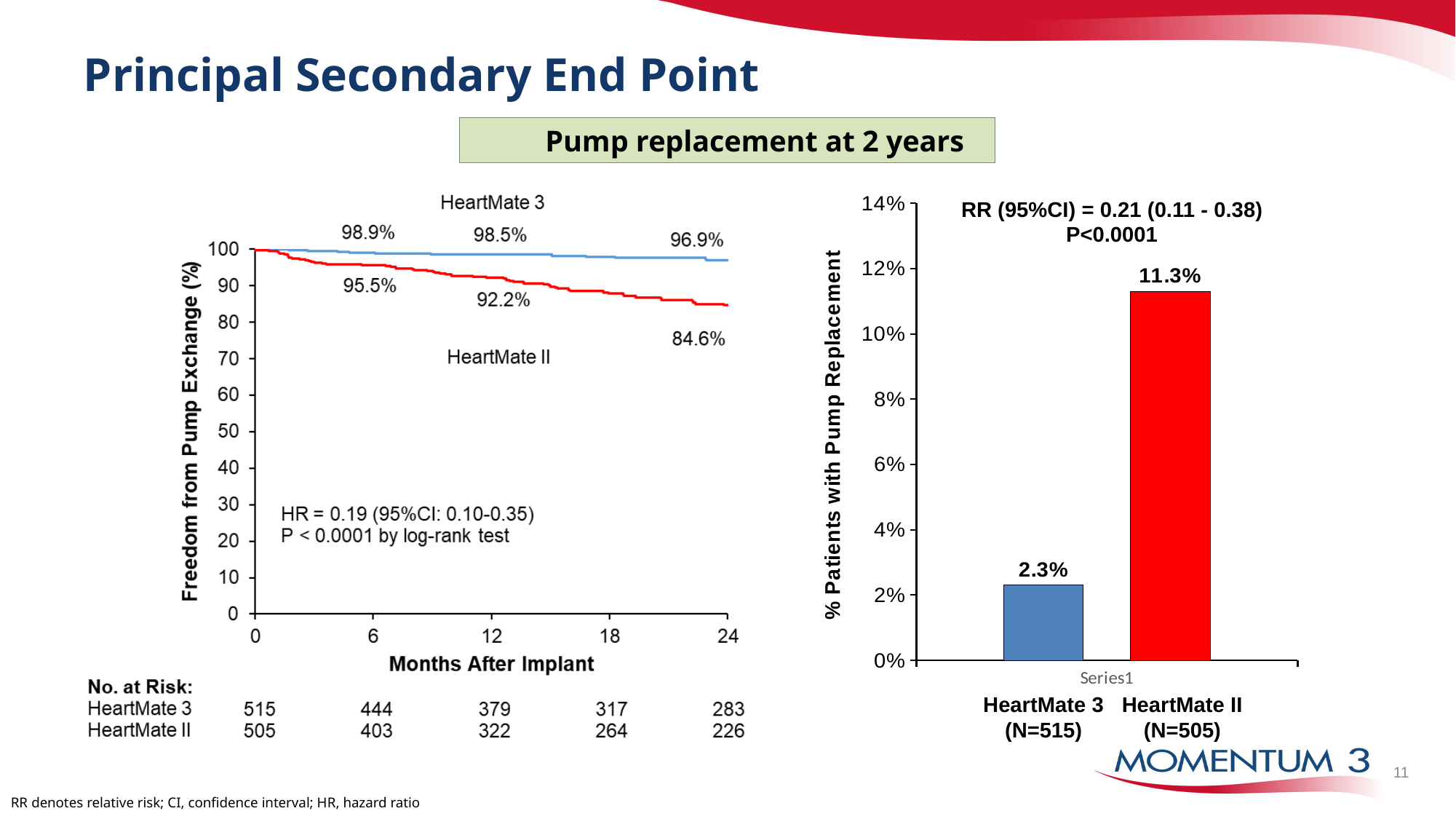
In the bar chart on the right, what is the percentage of patients with pump replacement for HeartMate II? 11.3% In the line chart on the left, how many HeartMate 3 patients were at risk at 12 months? 379 What kind of chart is the chart on the left of the slide? Line chart In the bar chart on the right, what is the difference in pump replacement percentage between HeartMate II and HeartMate 3? 9.0% In the line chart on the left, what is the freedom from pump exchange for HeartMate 3 at 24 months? 96.9% In the bar chart on the right, is the value for HeartMate II greater or less than 10%? greater How many bars are plotted in the bar chart on the right? 2 What kind of chart is the chart on the right of the slide? Bar chart In the bar chart on the right, which group has the higher percentage of patients with pump replacement? HeartMate II In the bar chart on the right, what is the percentage of patients with pump replacement for HeartMate 3? 2.3% In the line chart on the left, does the HeartMate II curve rise or fall as months after implant increase? Fall In the line chart on the left, what is the freedom from pump exchange for HeartMate II at 24 months? 84.6%